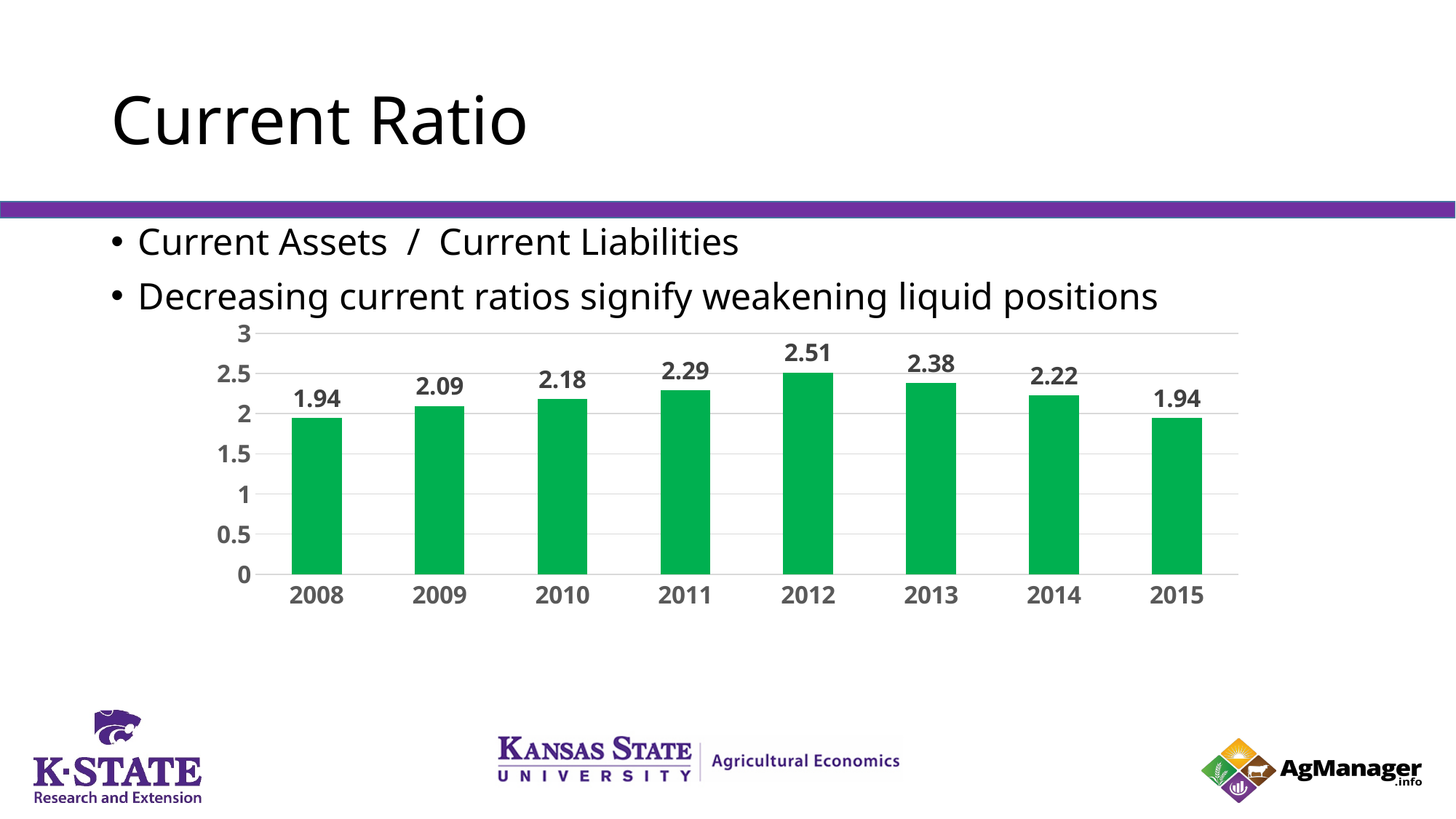
What is the current ratio for 2014? 2.22 What is the difference between the current ratio in 2012 and in 2015? 0.57 How many years are shown on the chart? 8 Does the current ratio rise or fall from 2012 to 2015? Fall What kind of chart is shown on the slide? Bar chart What is the current ratio for 2009? 2.09 Which year has the highest current ratio? 2012 Is the current ratio for 2012 greater or less than 2.5? greater What is the current ratio for 2012? 2.51 Which year has a larger current ratio, 2013 or 2014? 2013 What is the difference between the current ratio in 2011 and in 2010? 0.11 What is the lowest current ratio value shown on the chart? 1.94